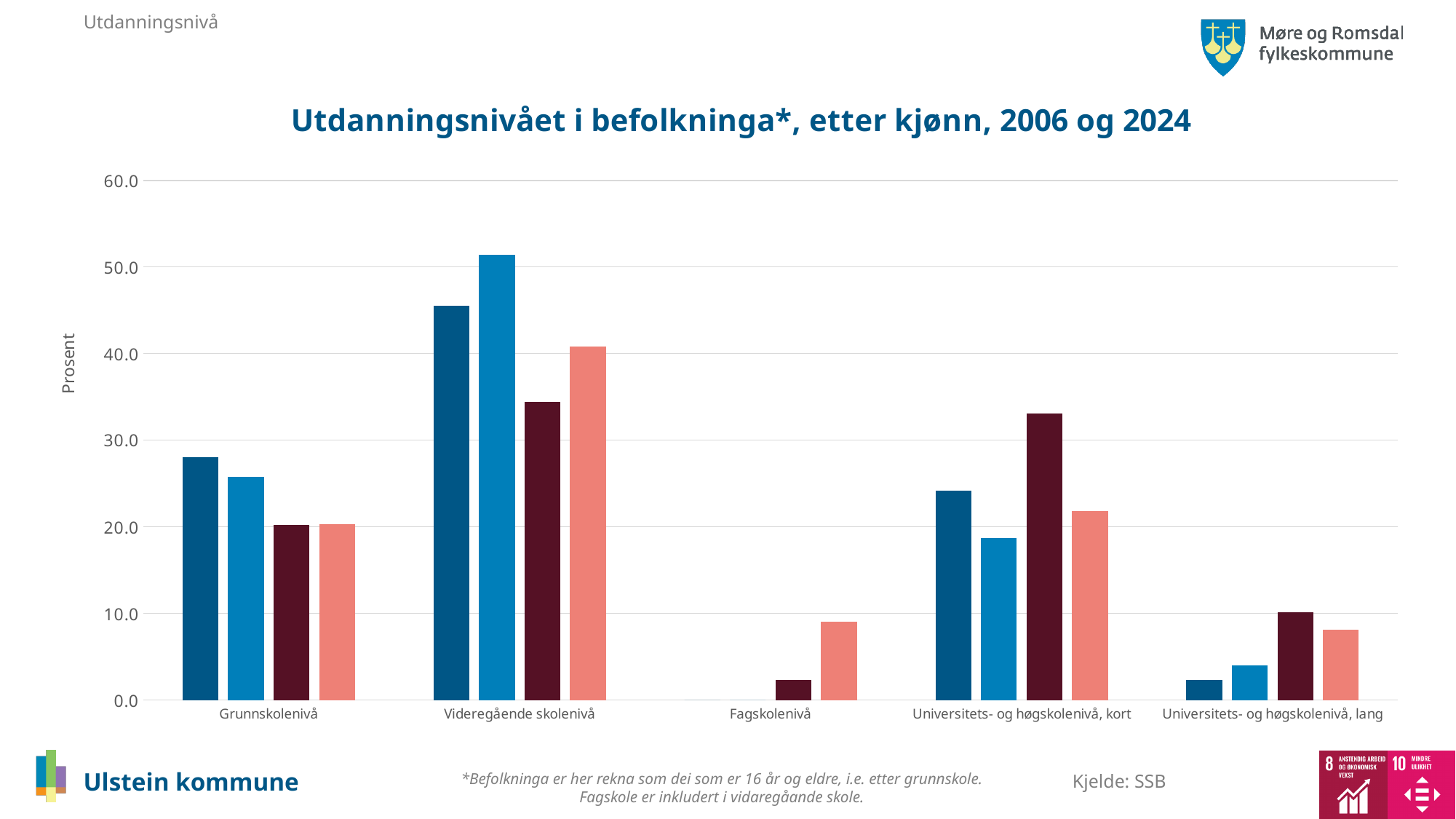
How many education-level categories are shown on the x axis? 5 Which category has the lowest bars overall in the chart? Fagskolenivå Is the dark blue bar for Grunnskolenivå greater or less than 30? less What kind of chart is shown on the slide? bar chart Is the salmon bar for Fagskolenivå greater or less than 10? less Which is larger: the dark blue bar for Grunnskolenivå or the dark blue bar for Videregående skolenivå? Videregående skolenivå Which category contains the tallest bar in the chart? Videregående skolenivå Is the light blue bar for Universitets- og høgskolenivå, kort greater or less than 20? less What is the label on the vertical axis of the chart? Prosent What is the title of the chart? Utdanningsnivået i befolkninga*, etter kjønn, 2006 og 2024